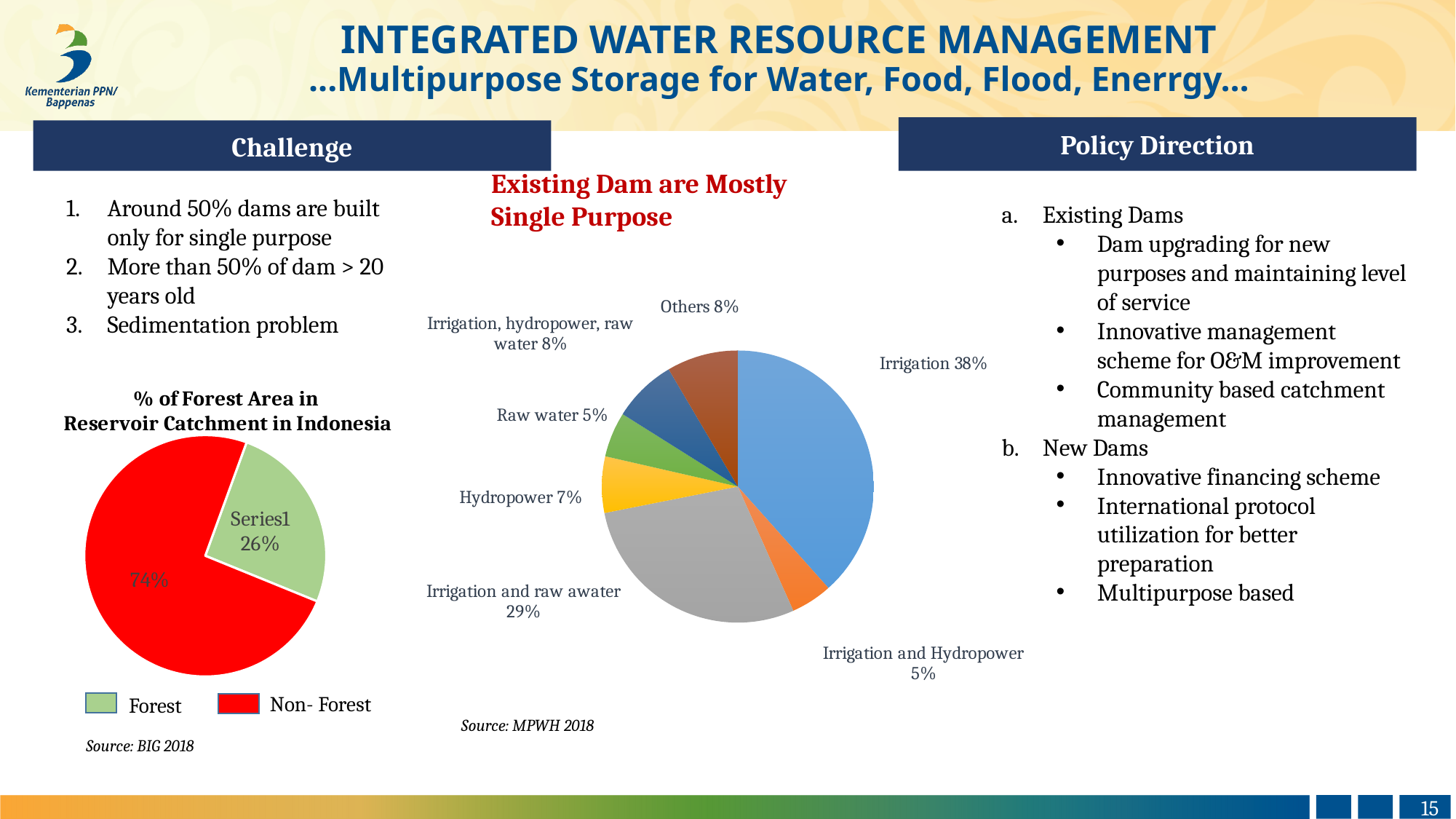
In the 'Existing Dam are Mostly Single Purpose' chart, what share is Irrigation? 38% In the 'Existing Dam are Mostly Single Purpose' chart, which is larger: Hydropower or Raw water? Hydropower How many entries does the legend of the '% of Forest Area in Reservoir Catchment in Indonesia' chart list? 2 In the '% of Forest Area in Reservoir Catchment in Indonesia' chart, what is the difference between the Non-Forest and Forest shares? 48% In the '% of Forest Area in Reservoir Catchment in Indonesia' chart, what share is Forest? 26% In the '% of Forest Area in Reservoir Catchment in Indonesia' chart, what share is Non-Forest? 74% What kind of chart is the '% of Forest Area in Reservoir Catchment in Indonesia' chart? Pie chart In the 'Existing Dam are Mostly Single Purpose' chart, how many categories are shown? 7 In the 'Existing Dam are Mostly Single Purpose' chart, what is the difference between the Irrigation share and the Irrigation and raw water share? 9% In the 'Existing Dam are Mostly Single Purpose' chart, which category has the largest share? Irrigation